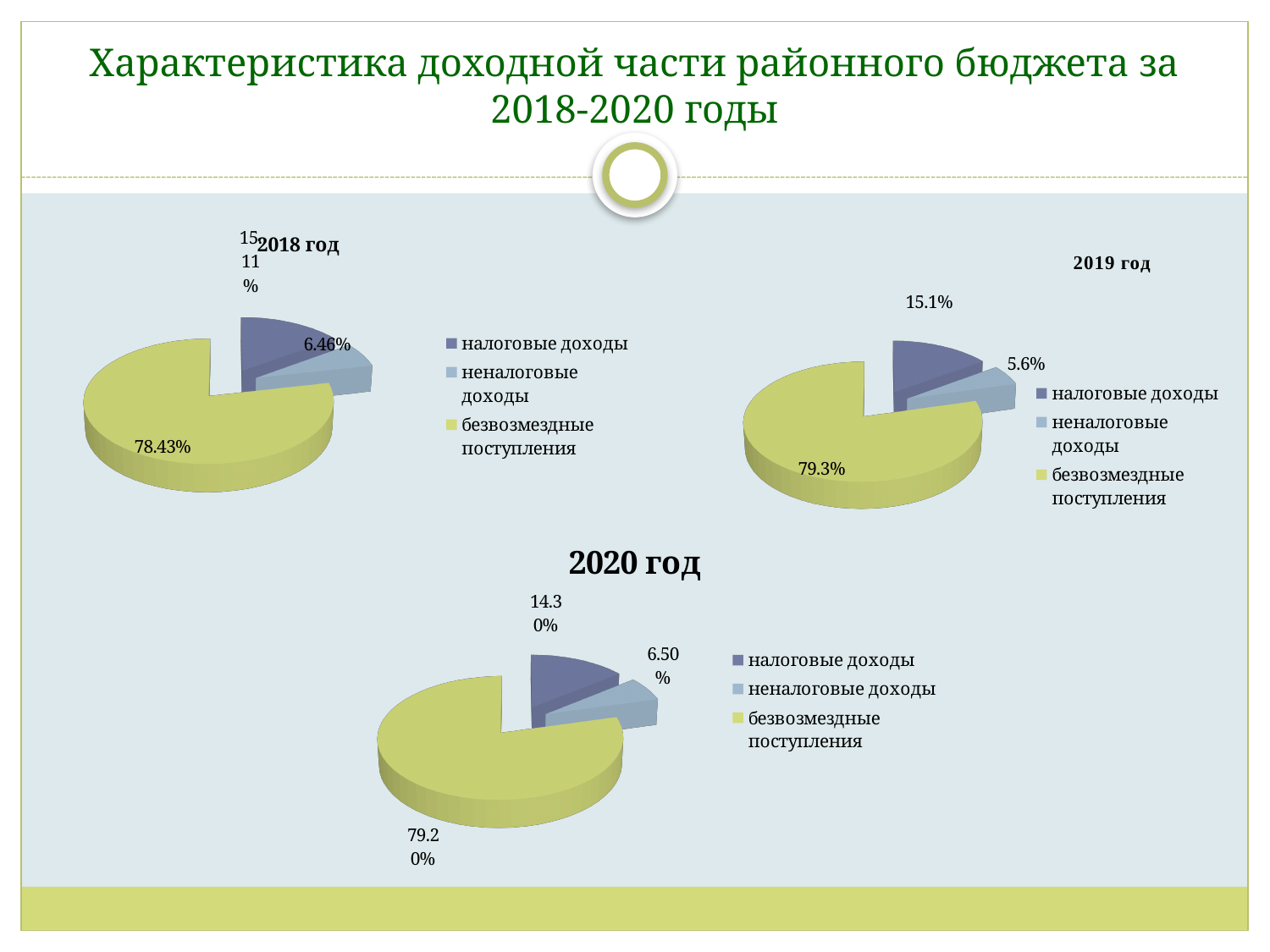
How many categories does the legend of the 2018 год chart list? 3 In the 2019 год chart, what share is shown for налоговые доходы? 15.1% In the 2019 год chart, what share is shown for безвозмездные поступления? 79.3% In the 2020 год chart, what share is shown for неналоговые доходы? 6.50% In the 2020 год chart, what share is shown for налоговые доходы? 14.30% What type of chart is the 2020 год chart? pie chart In the 2018 год chart, what share is shown for неналоговые доходы? 6.46% In the 2019 год chart, which category has the largest share? безвозмездные поступления In the 2018 год chart, which is larger: налоговые доходы or неналоговые доходы? налоговые доходы In the 2018 год chart, what share is shown for безвозмездные поступления? 78.43% In the 2019 год chart, what is the difference between the shares of налоговые доходы and неналоговые доходы? 9.5% In the 2020 год chart, which category has the smallest share? неналоговые доходы